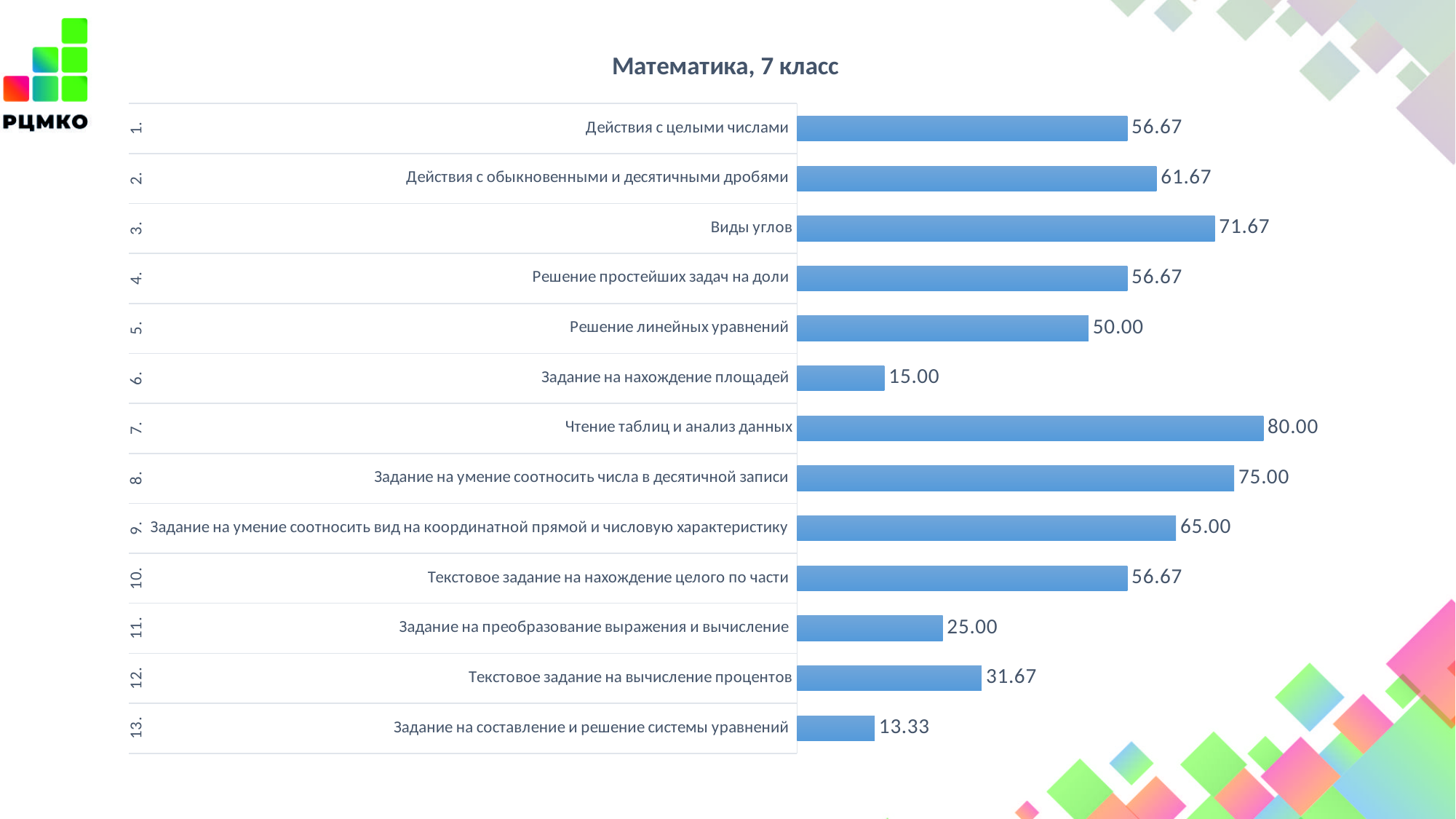
How many categories are shown in the chart? 13 What is the difference between the values for "Чтение таблиц и анализ данных" and "Задание на умение соотносить числа в десятичной записи"? 5.00 What is the value for "Текстовое задание на вычисление процентов"? 31.67 Which category has the lowest value? Задание на составление и решение системы уравнений Which is larger: the value for "Решение линейных уравнений" or the value for "Задание на преобразование выражения и вычисление"? Решение линейных уравнений How many categories have a value of 56.67? 3 Which category has the highest value? Чтение таблиц и анализ данных What is the title of the chart? Математика, 7 класс What is the value for "Задание на нахождение площадей"? 15.00 What is the value for "Виды углов"? 71.67 What kind of chart is shown on the slide? Bar chart What is the difference between the values for "Действия с обыкновенными и десятичными дробями" and "Действия с целыми числами"? 5.00